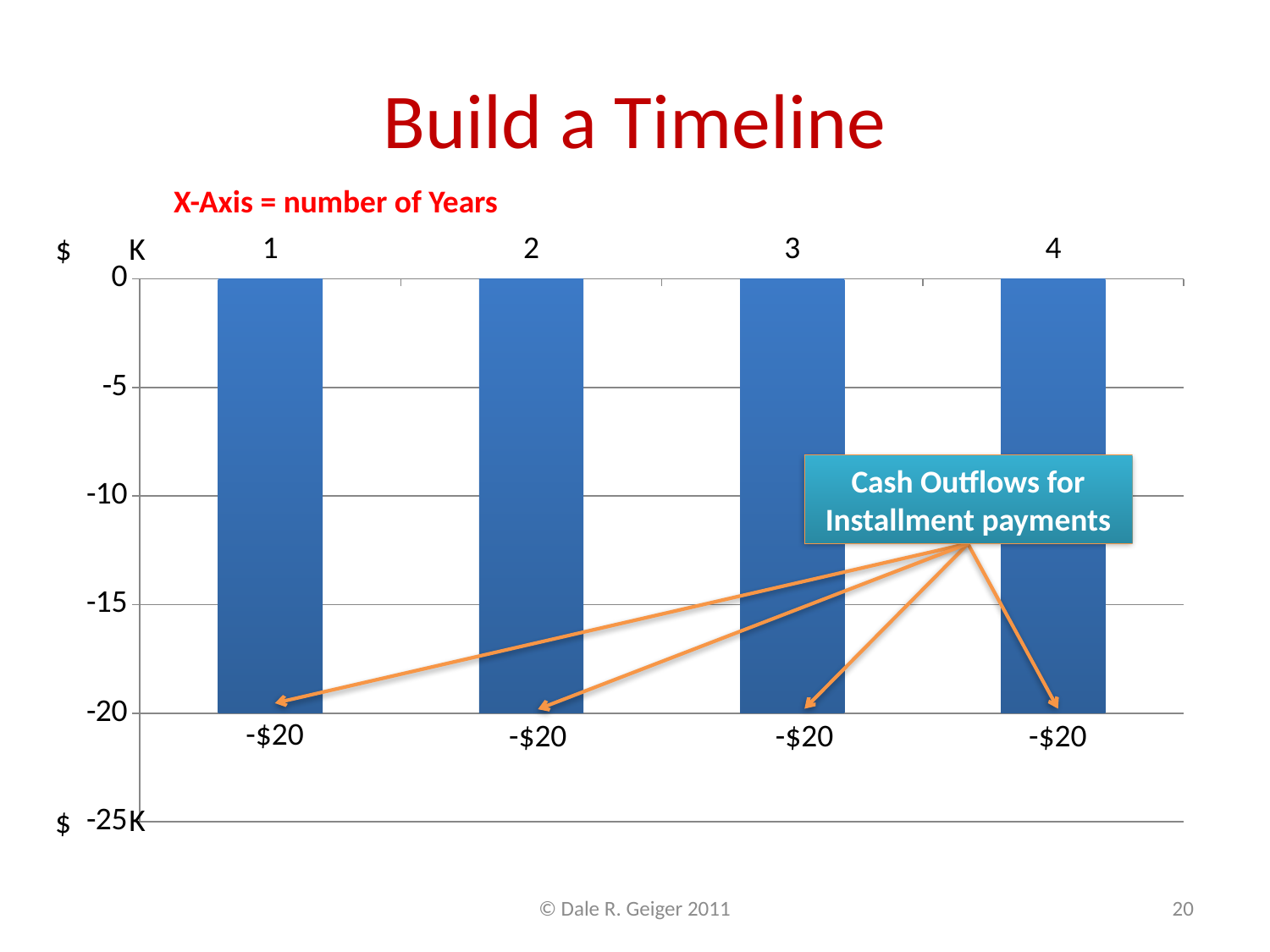
What is the title of the slide containing the chart? Build a Timeline What is the difference between the value for year 2 and the value for year 4? $0 Do the values rise, fall, or stay the same from year 1 to year 4? stay the same What is the value for year 4? -$20 Is the value for year 2 larger than, smaller than, or equal to the value for year 3? equal Is the value for year 1 greater or less than -10? less What is the value for year 3? -$20 According to the callout on the chart, what do the bars represent? Cash Outflows for Installment payments What kind of chart is shown on the slide? bar chart What is the value for year 1? -$20 How many bars (years) are plotted on the chart? 4